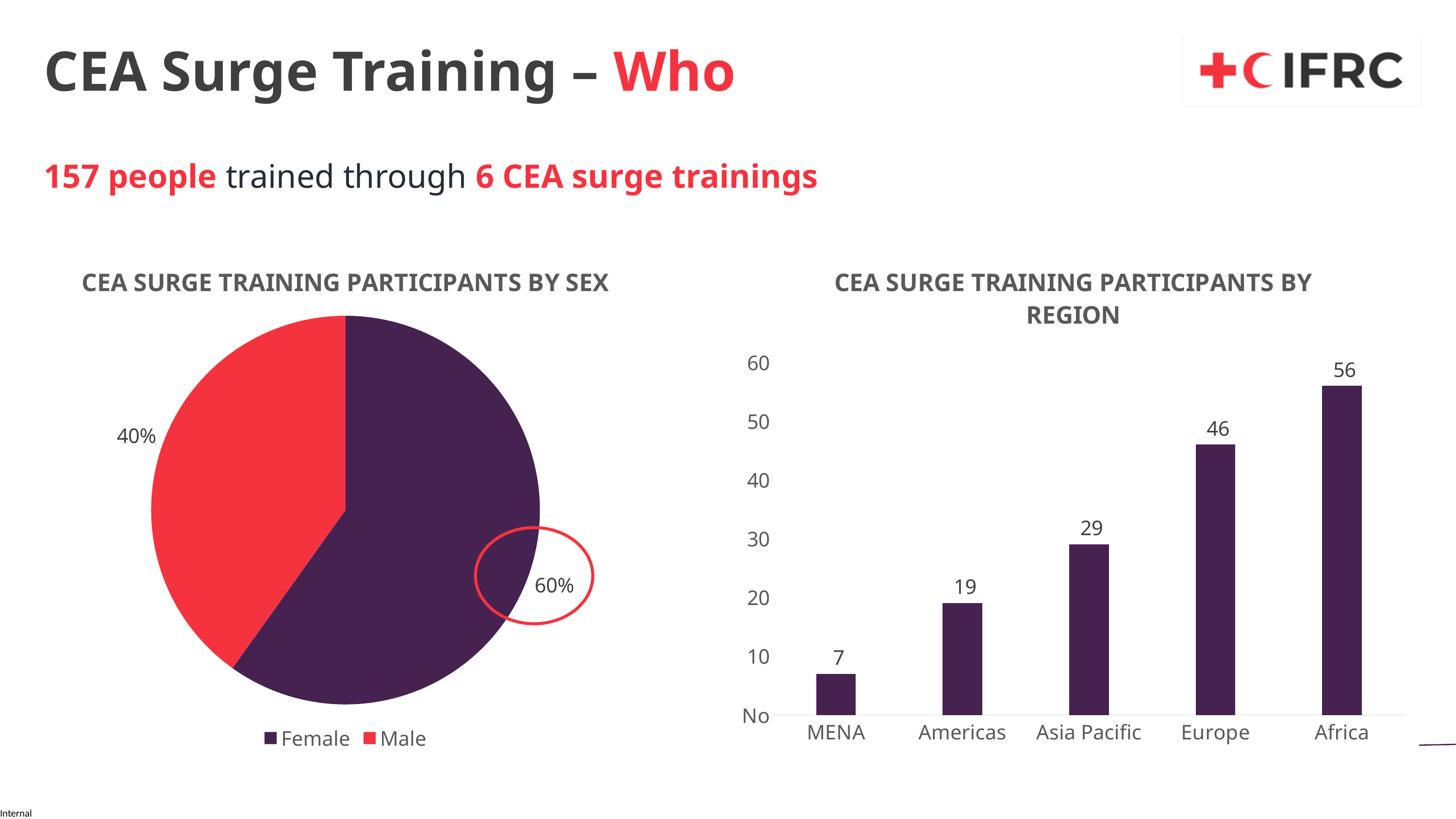
In the 'CEA Surge Training Participants by Region' chart, do the values rise or fall from MENA to Africa along the x axis? Rise In the 'CEA Surge Training Participants by Region' chart, how many participants are from MENA? 7 In the 'CEA Surge Training Participants by Region' chart, what is the difference between the Africa and Asia Pacific values? 27 In the 'CEA Surge Training Participants by Region' chart, which has more participants, Americas or Asia Pacific? Asia Pacific In the 'CEA Surge Training Participants by Sex' chart, what share of participants are female? 60% In the 'CEA Surge Training Participants by Region' chart, how many participants are from Europe? 46 How many regions are shown in the 'CEA Surge Training Participants by Region' chart? 5 In the 'CEA Surge Training Participants by Region' chart, which region has the lowest number of participants? MENA In the 'CEA Surge Training Participants by Sex' chart, what share of participants are male? 40% What kind of chart is 'CEA Surge Training Participants by Sex'? Pie chart In the 'CEA Surge Training Participants by Region' chart, which region has the highest number of participants? Africa How many entries does the legend of the 'CEA Surge Training Participants by Sex' chart list? 2